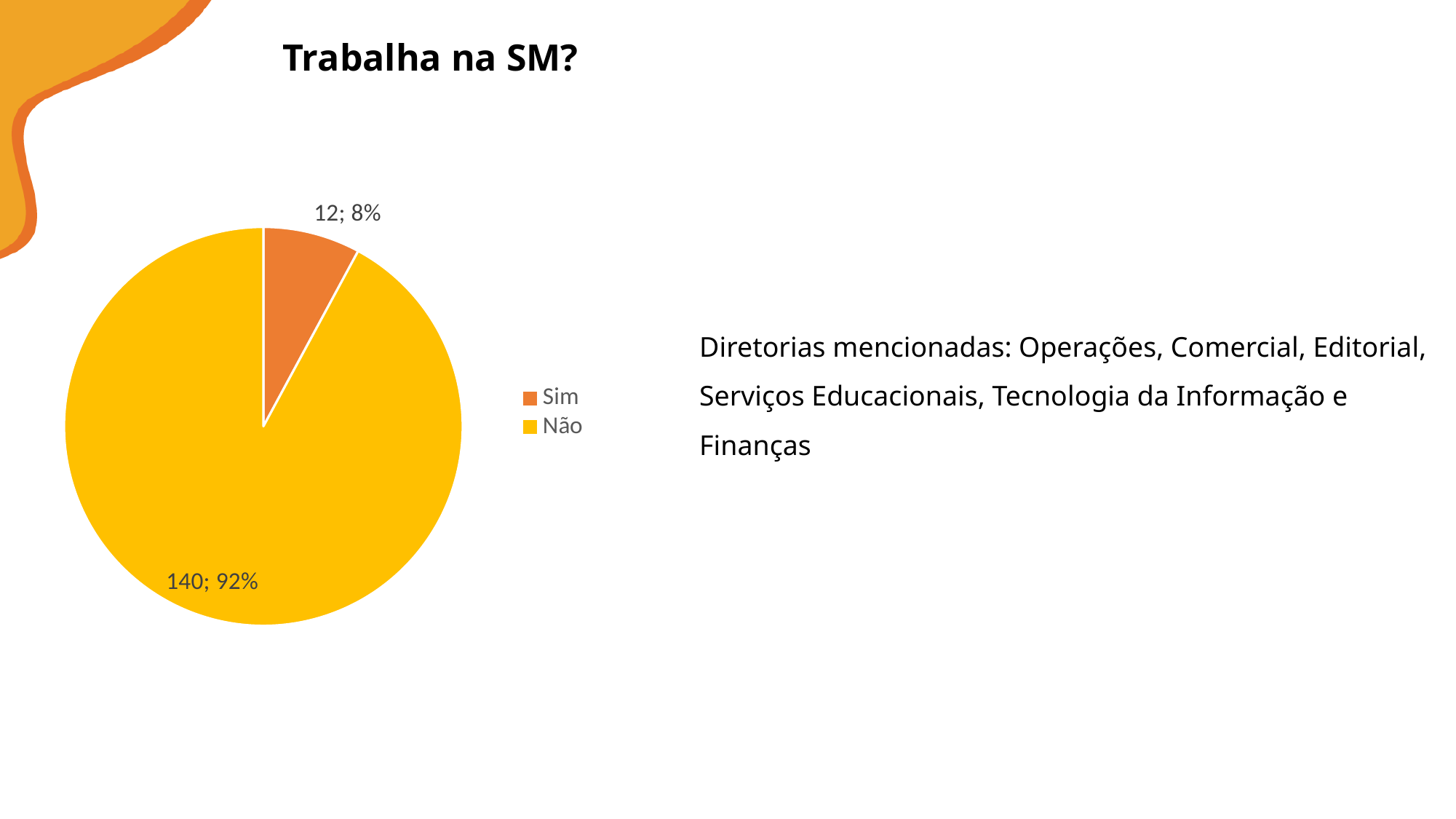
What kind of chart is shown on the slide? pie chart Which category has the largest slice? Não What share of the pie does "Sim" represent? 8% How many slices does the pie chart have? 2 What is the count for "Não"? 140 What is the title of the chart? Trabalha na SM? What is the difference between the counts for "Não" and "Sim"? 128 How many entries does the legend list? 2 Which is larger, the count for "Sim" or the count for "Não"? Não Which category has the smallest slice? Sim What is the count for "Sim"? 12 What share of the pie does "Não" represent? 92%